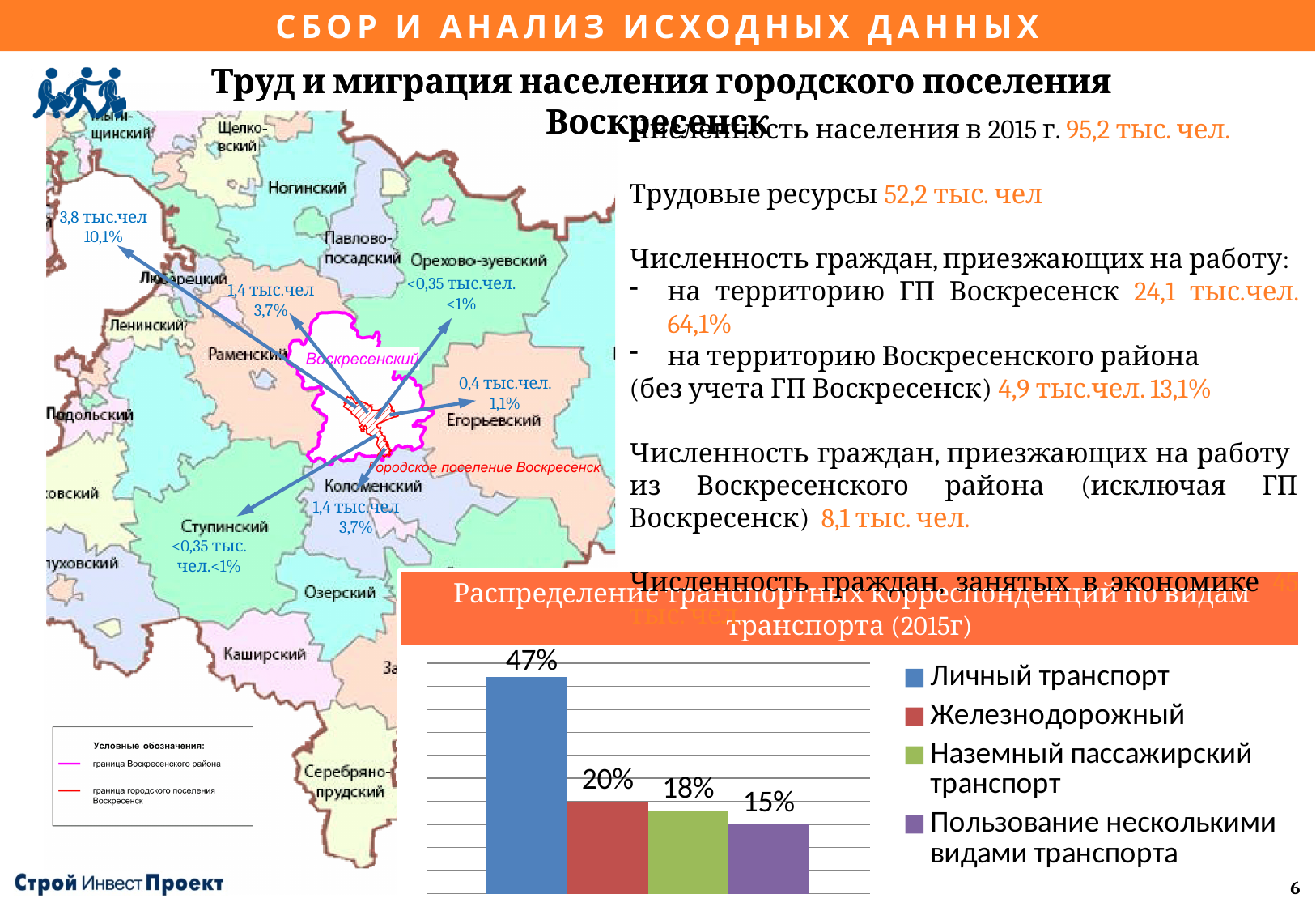
What type of chart is used for 'Распределение транспортных корреспонденций по видам транспорта (2015г)'? Bar chart What is the value for Железнодорожный in the transport distribution chart? 20% What is the value for Личный транспорт in the chart 'Распределение транспортных корреспонденций по видам транспорта (2015г)'? 47% In the transport distribution chart, which is larger: Железнодорожный or Наземный пассажирский транспорт? Железнодорожный What is the value for Наземный пассажирский транспорт in the transport distribution chart? 18% Which transport type has the lowest share in the transport distribution chart? Пользование несколькими видами транспорта What is the value for Пользование несколькими видами транспорта in the transport distribution chart? 15% How many entries does the legend of the transport distribution chart list? 4 What is the difference between the shares of Наземный пассажирский транспорт and Пользование несколькими видами транспорта in the transport distribution chart? 3% What is the difference between the shares of Личный транспорт and Железнодорожный in the transport distribution chart? 27% How many bars are shown in the transport distribution chart? 4 Which transport type has the highest share in the transport distribution chart? Личный транспорт